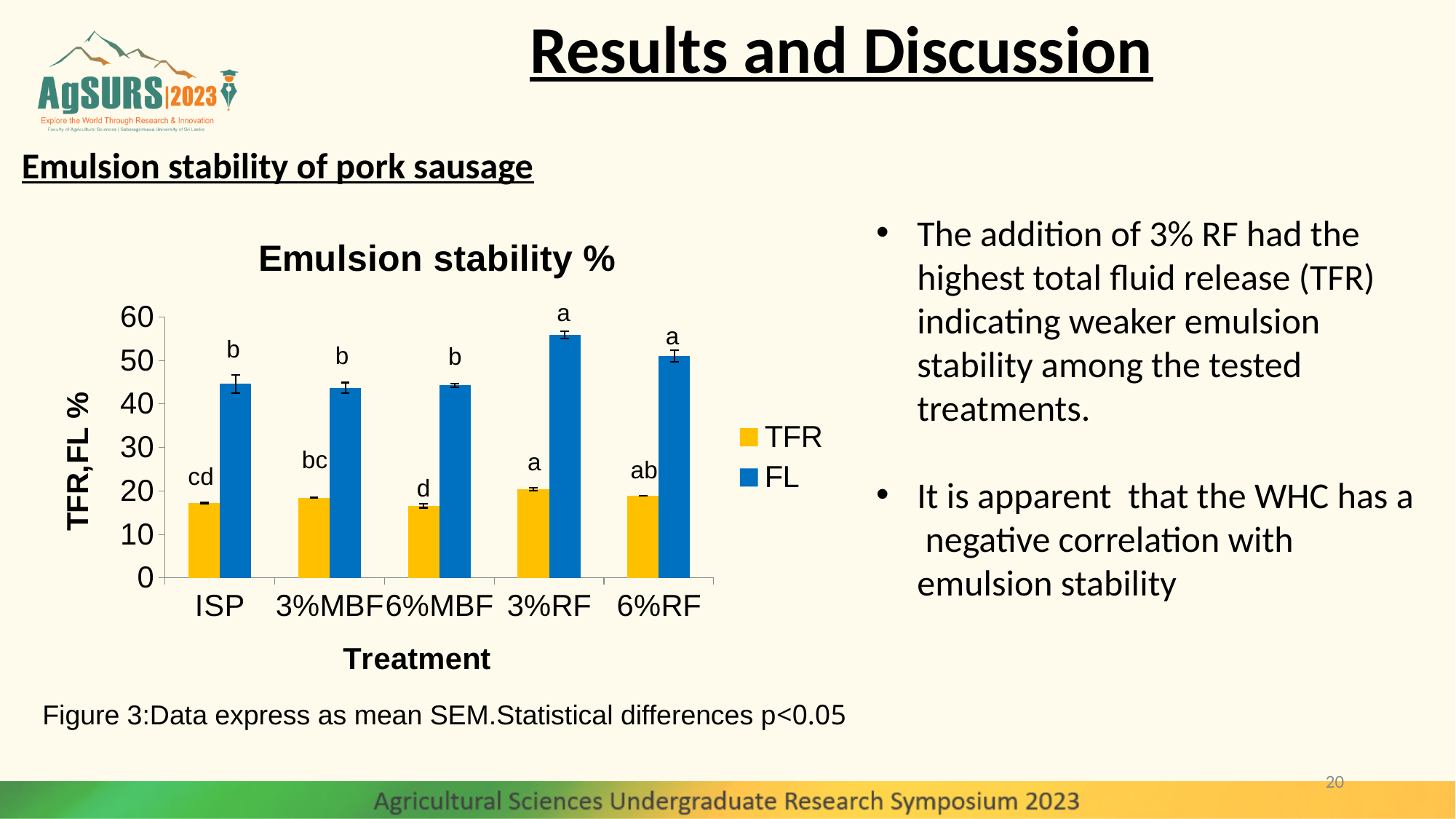
Which treatment has the highest FL value in the Emulsion stability % chart? 3%RF How many series does the legend of the Emulsion stability % chart list? 2 Is the FL value for ISP greater or less than 50? less Which has the larger FL value, 3%RF or 6%RF? 3%RF Is the FL value for 3%RF greater or less than 50? greater Is the TFR value for 6%MBF greater or less than 20? less For the ISP treatment, which is larger, TFR or FL? FL What is the title of the chart on the slide? Emulsion stability % How many treatments are shown on the x axis of the Emulsion stability % chart? 5 What kind of chart is shown on the slide? bar chart What is the label of the x axis of the chart? Treatment